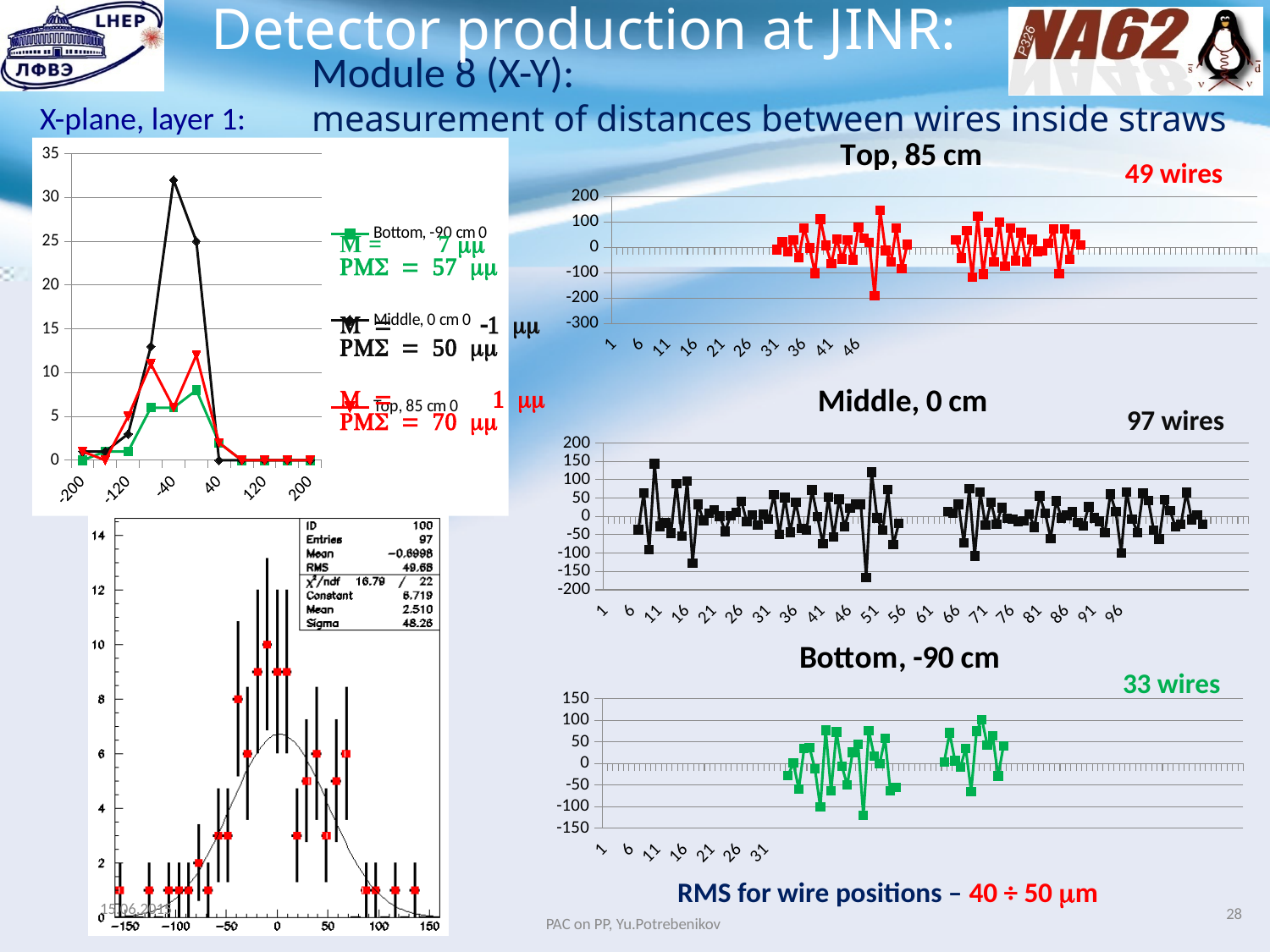
How many wires are reported for the 'Bottom, -90 cm' chart? 33 wires In the top-left line chart, is the peak value of the 'Bottom, -90 cm' series greater or less than 10? less How many series does the legend of the top-left line chart list? 3 In the top-left line chart, is the peak value of the 'Middle, 0 cm' series greater or less than 30? greater Of the three charts on the right (Top, Middle, Bottom), which one has the most wires? Middle, 0 cm What is the lowest y-axis tick shown on the 'Top, 85 cm' chart? -300 What kind of chart is the top-left chart on the slide (the one with the -200 to 200 x axis)? line chart In the bottom-left histogram, what RMS value is printed in the statistics box? 49.68 In the top-left line chart, which series reaches the highest peak? Middle, 0 cm How many wires are reported for the 'Middle, 0 cm' chart? 97 wires In the top-left line chart, which series has the lowest peak? Bottom, -90 cm How many wires are reported for the 'Top, 85 cm' chart? 49 wires